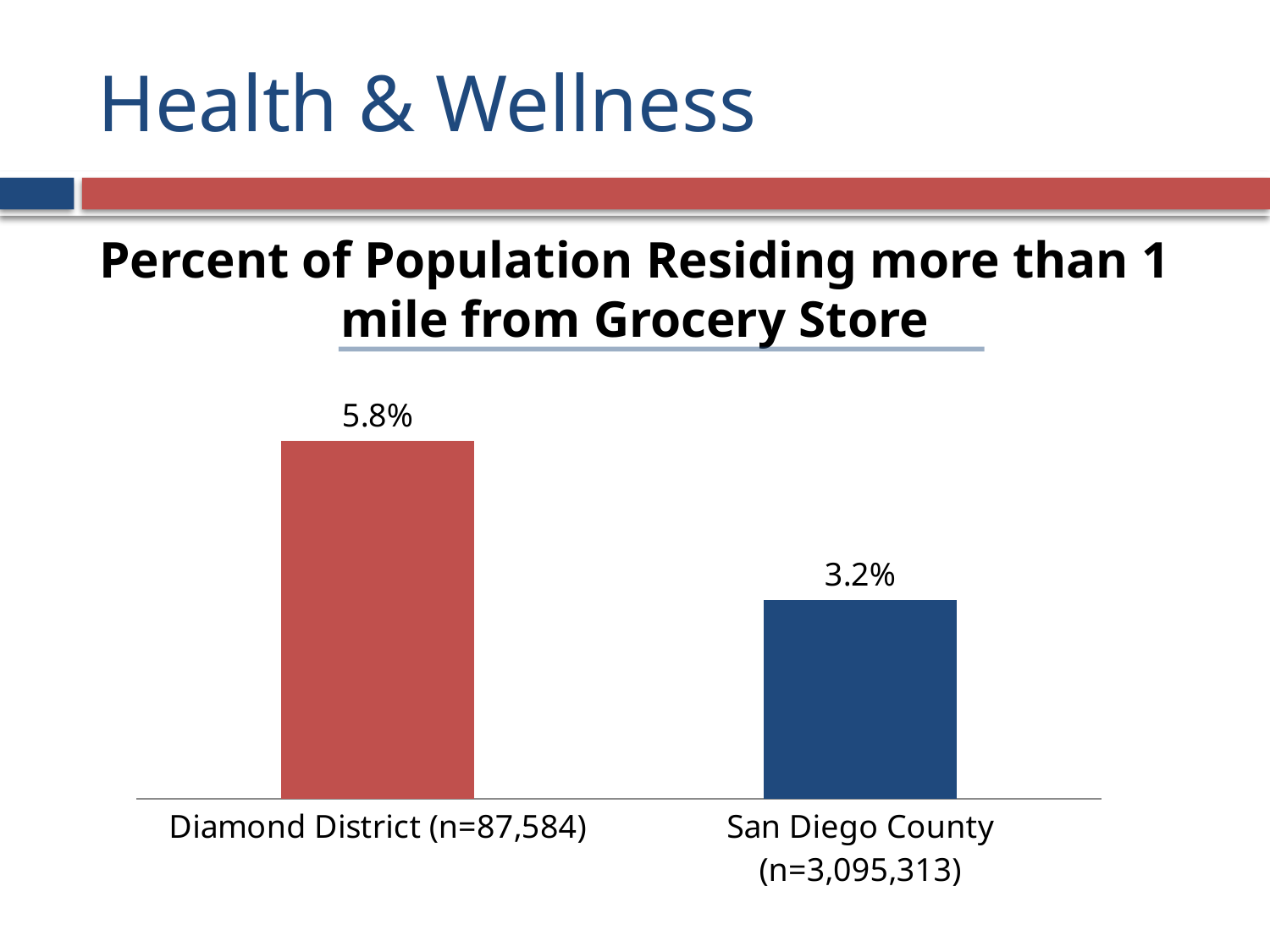
How many categories are shown in the chart? 2 What is the value for Diamond District (n=87,584)? 5.8% Which is larger, the value for Diamond District or the value for San Diego County? Diamond District What is the title of the chart? Percent of Population Residing more than 1 mile from Grocery Store What is the difference between the values for Diamond District and San Diego County? 2.6% What colour is the bar for San Diego County? Blue Which category has the lowest value? San Diego County (n=3,095,313) What kind of chart is shown on the slide? Bar chart Which category has the highest value? Diamond District (n=87,584) What is the value for San Diego County (n=3,095,313)? 3.2%